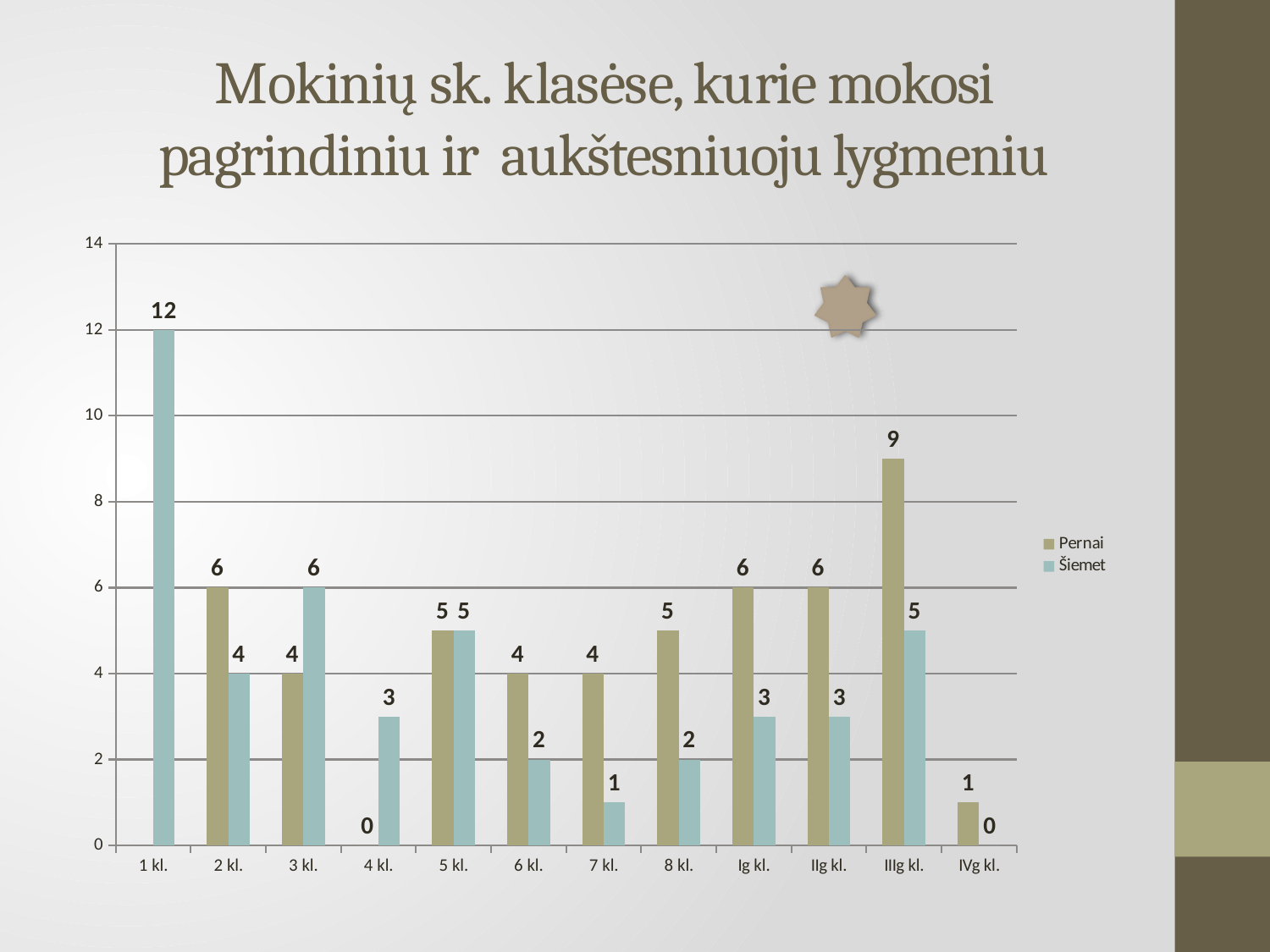
What is the Šiemet value for 4 kl.? 3 How many series does the legend list? 2 Which class has the highest Pernai value? IIIg kl. Which class has the highest Šiemet value? 1 kl. How many classes are shown on the x axis? 12 What is the Pernai value for 8 kl.? 5 What kind of chart is shown on the slide? Bar chart Which class has the lowest Šiemet value? IVg kl. What is the Pernai value for IIIg kl.? 9 Which is larger for 3 kl., the Pernai value or the Šiemet value? Šiemet What is the Šiemet value for 1 kl.? 12 What is the difference between the Pernai and Šiemet values for IIIg kl.? 4